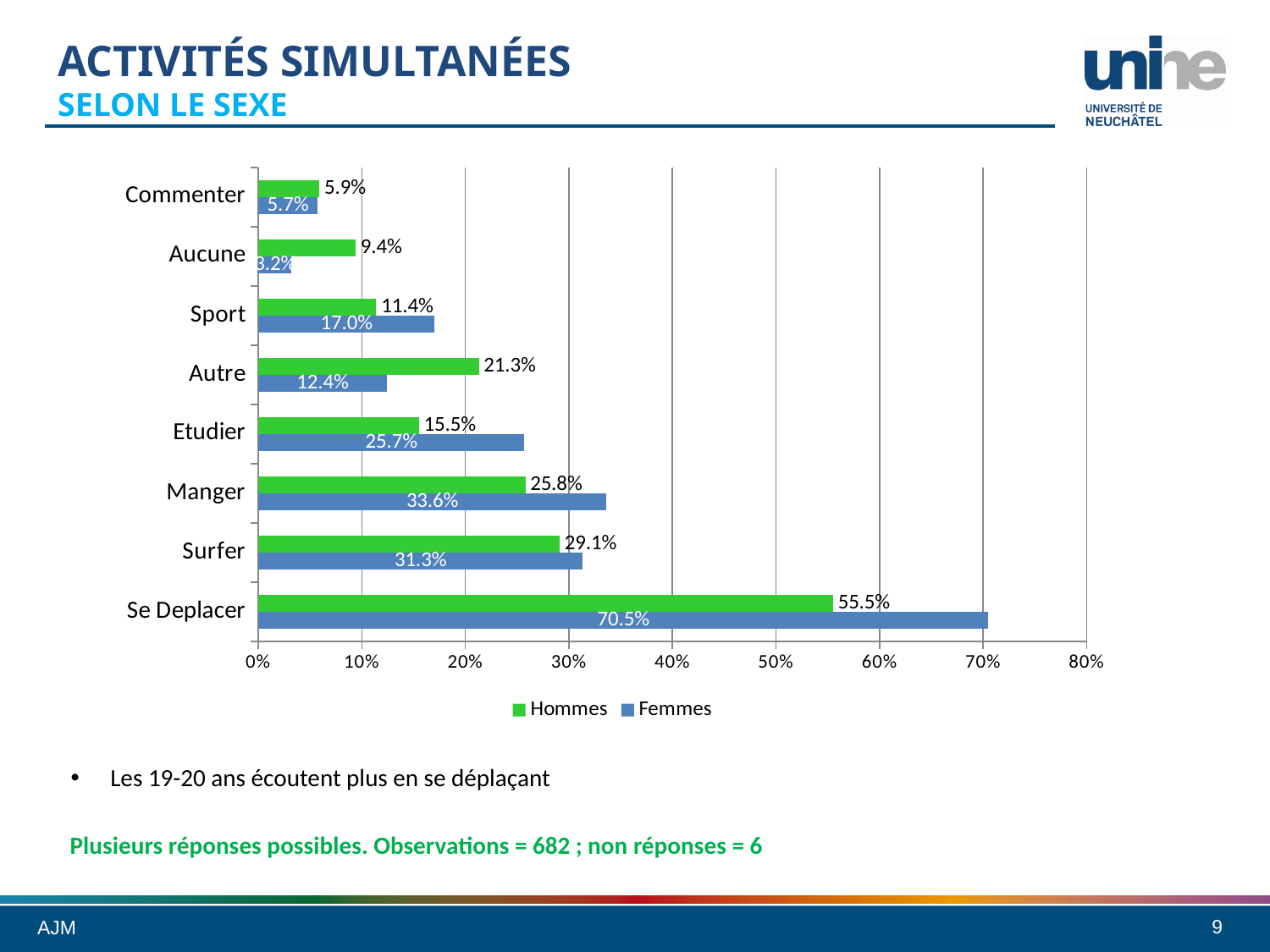
What is the Femmes value for Etudier? 25.7% Which category has the lowest Femmes value? Aucune Which category has the highest Hommes value? Se Deplacer What kind of chart is shown on the slide? Bar chart What is the Hommes value for Autre? 21.3% What is the difference between the Hommes and Femmes values for Aucune? 6.2% How many series does the legend list? 2 What is the difference between the Femmes and Hommes values for Se Deplacer? 15.0% For Manger, which is larger: the Hommes value or the Femmes value? Femmes How many categories are shown on the chart? 8 For Autre, which is larger: the Hommes value or the Femmes value? Hommes What is the Femmes value for Se Deplacer? 70.5%